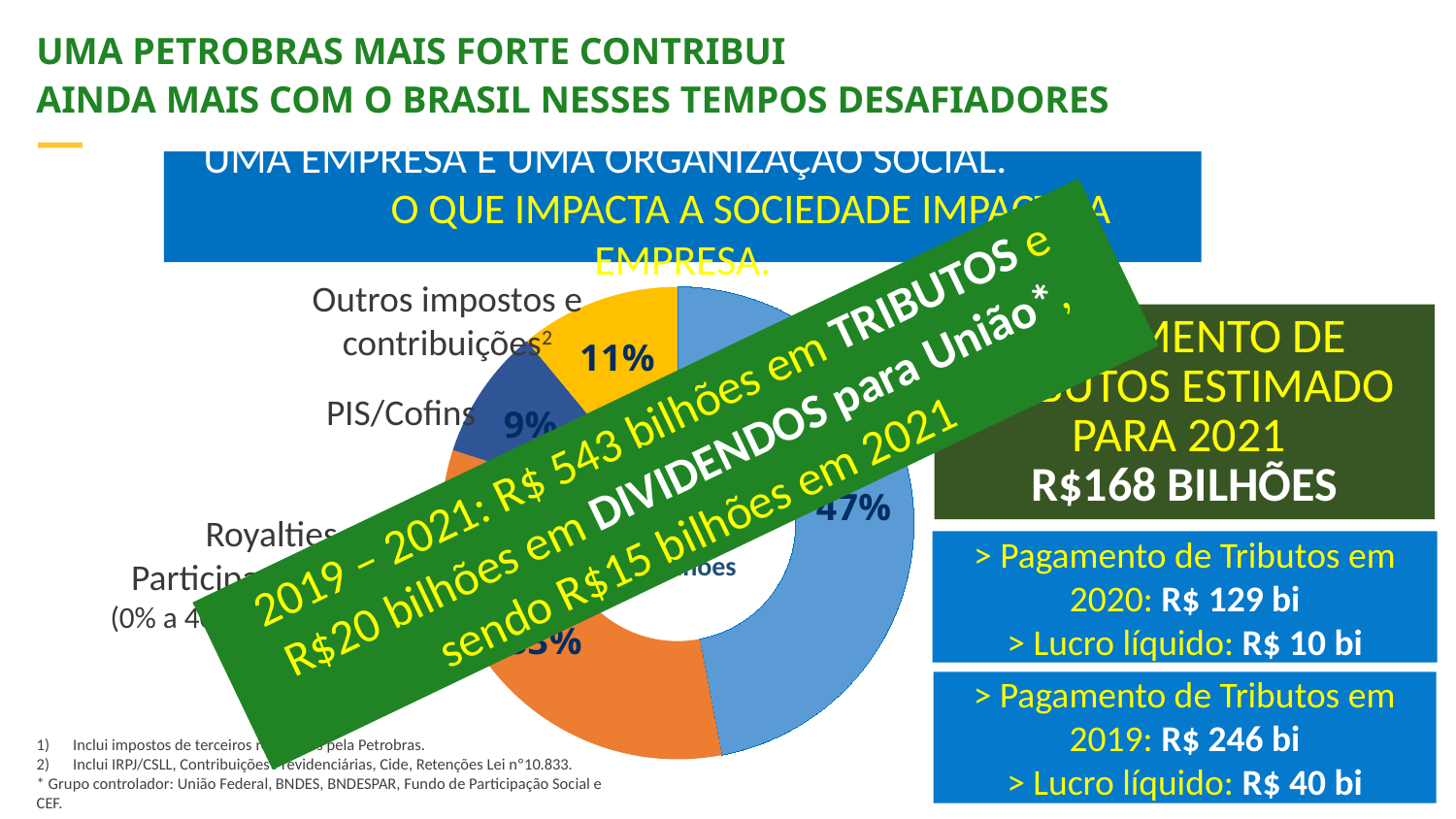
By how many percentage points does "Outros impostos e contribuições" exceed "PIS/Cofins"? 2 percentage points Which labelled category has the smallest slice in the doughnut chart? PIS/Cofins Is the largest slice of the doughnut chart greater or less than 40%? greater What percentage is shown for "PIS/Cofins"? 9% Which is larger, the share for "Outros impostos e contribuições" or for "PIS/Cofins"? Outros impostos e contribuições What kind of chart is shown on the slide? Doughnut (pie) chart What colour is the "PIS/Cofins" slice? Dark blue What percentage is printed on the largest slice of the doughnut chart? 47% How many slices does the doughnut chart have? 4 What colour is the slice labelled 11%? Yellow What percentage is shown for "Outros impostos e contribuições"? 11%